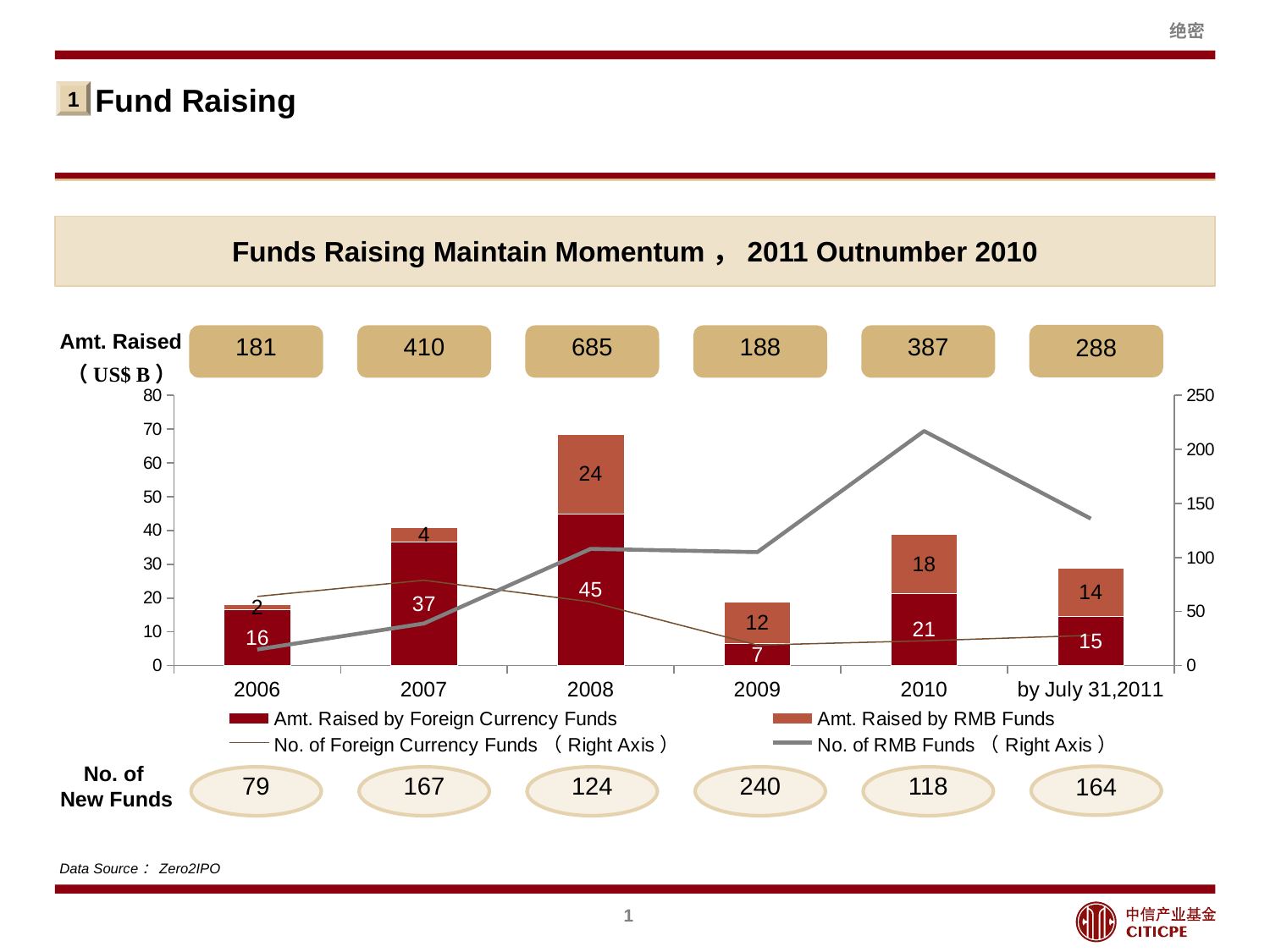
What is the total height of the stacked bar for 2008 (Foreign Currency Funds plus RMB Funds)? 69 What is the difference between the Amt. Raised by Foreign Currency Funds and the Amt. Raised by RMB Funds in 2008? 21 In which year is the Amt. Raised by Foreign Currency Funds the lowest? 2009 How many time periods are shown on the x axis of the chart? 6 What is the Amt. Raised by Foreign Currency Funds in 2008? 45 Is the No. of RMB Funds in 2010 greater or less than 200? greater What is the Amt. Raised by RMB Funds in 2010? 18 Is the No. of Foreign Currency Funds in 2009 greater or less than 50? less In which year is the Amt. Raised by Foreign Currency Funds the highest? 2008 In 2009, which is larger: the Amt. Raised by Foreign Currency Funds or the Amt. Raised by RMB Funds? Amt. Raised by RMB Funds In which year does the No. of RMB Funds line reach its peak? 2010 How many series does the chart legend list? 4